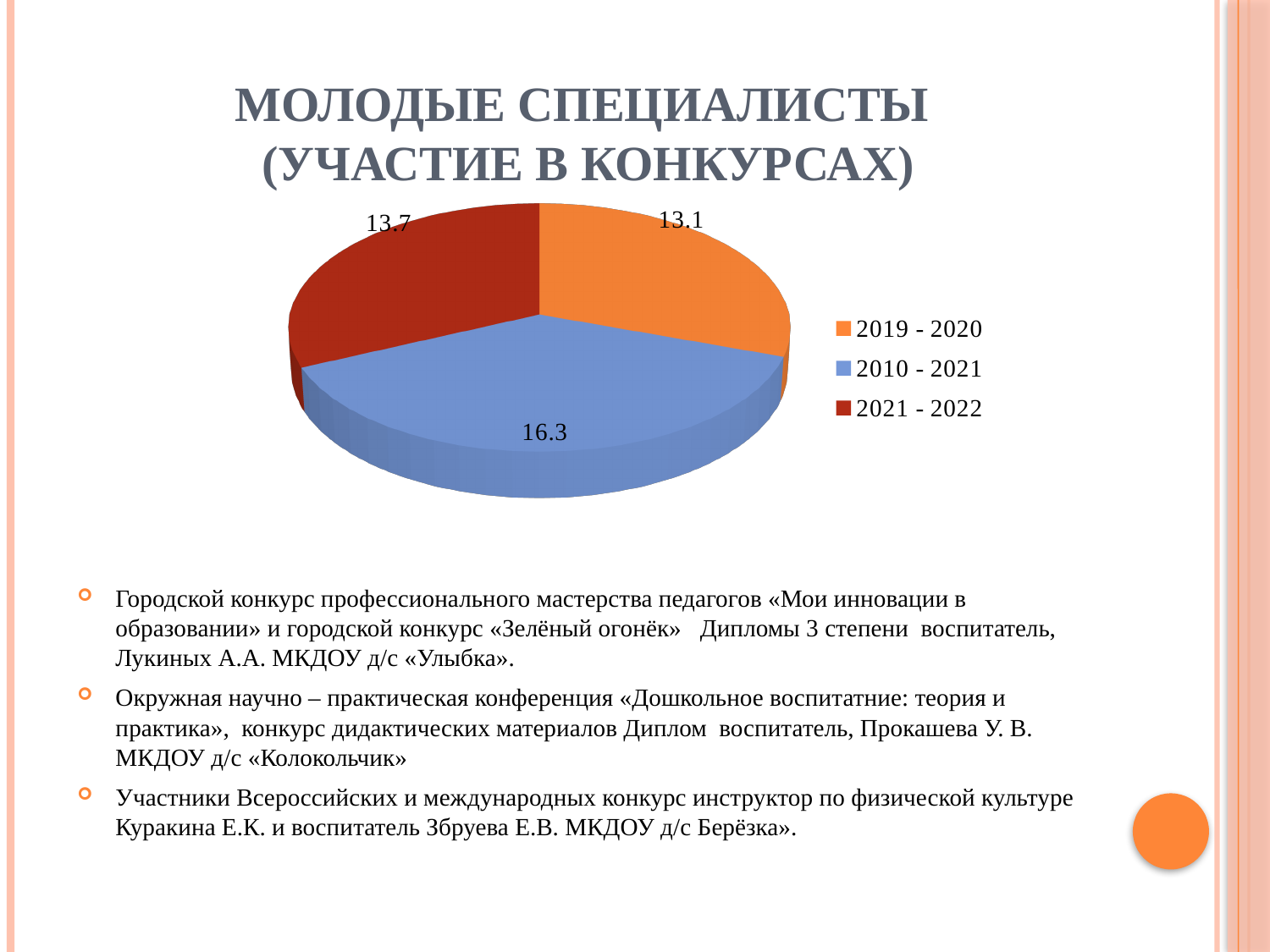
How many slices does the pie chart have? 3 What type of chart is shown on the slide? Pie chart Which period has the smallest slice of the pie? 2019 - 2020 How many entries does the legend list? 3 What is the difference between the 2010 - 2021 value and the 2019 - 2020 value? 3.2 What is the difference between the 2021 - 2022 value and the 2019 - 2020 value? 0.6 What colour is the 2010 - 2021 slice in the pie chart? Blue Which period has the largest slice of the pie? 2010 - 2021 What is the value for the 2021 - 2022 slice? 13.7 What is the value for the 2019 - 2020 slice? 13.1 What is the value for the 2010 - 2021 slice? 16.3 Which is larger, the value for 2021 - 2022 or the value for 2019 - 2020? 2021 - 2022